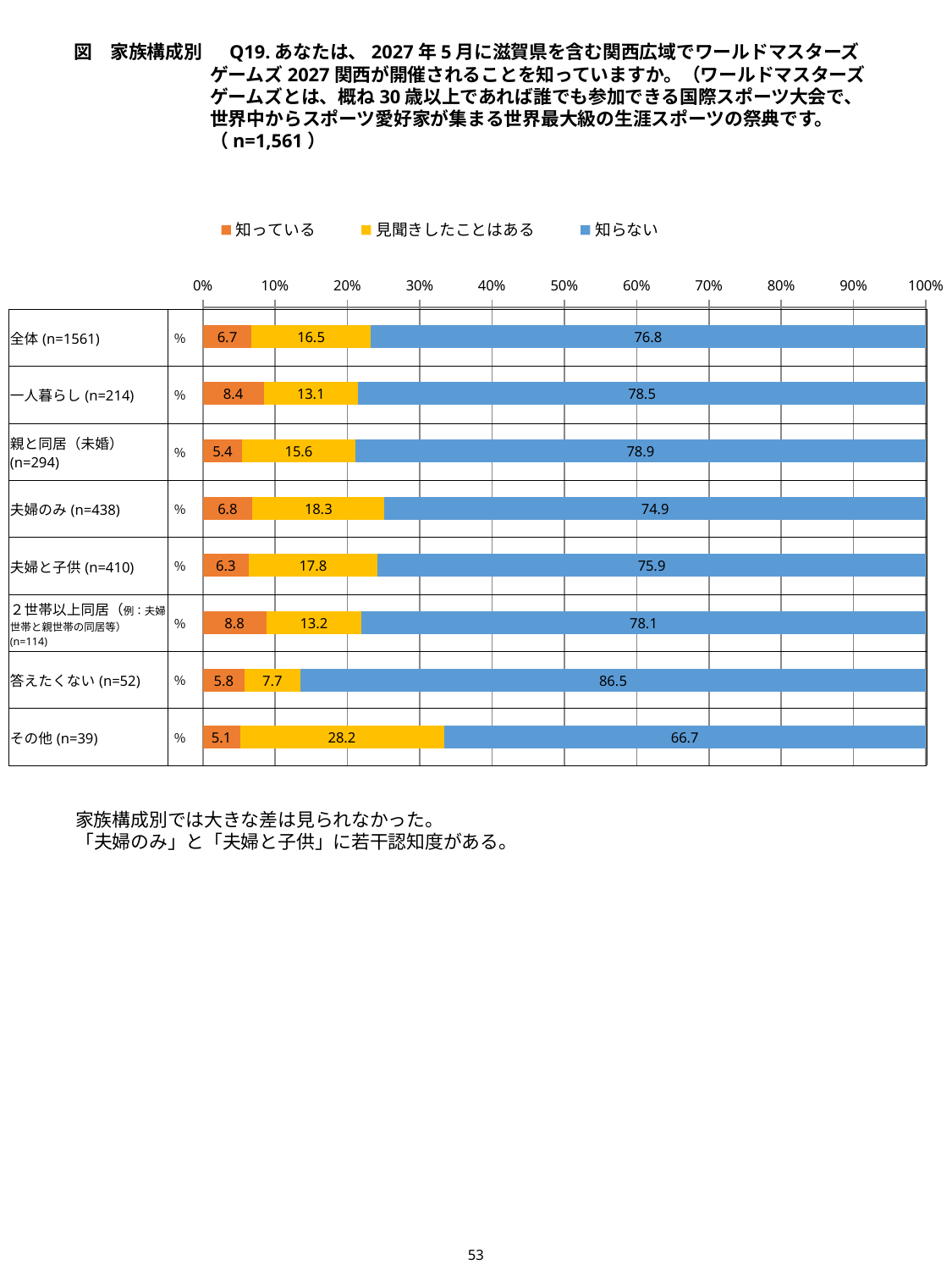
What is the value of 知らない for 全体 (n=1561)? 76.8 What is the value of 見聞きしたことはある for その他 (n=39)? 28.2 What is the value of 知っている for 一人暮らし (n=214)? 8.4 Which category has the lowest value for 知っている? その他 (n=39) How many categories (rows) are plotted in the chart? 8 What kind of chart is shown on the slide? stacked bar chart What is the difference between the 知らない values for 答えたくない (n=52) and その他 (n=39)? 19.8 Which is larger, the 見聞きしたことはある value for 夫婦のみ (n=438) or for 夫婦と子供 (n=410)? 夫婦のみ (n=438) How many series does the legend list? 3 Which category has the highest value for 知らない? 答えたくない (n=52) What is the total of the stacked bar for 親と同居（未婚）(n=294)? 99.9 Which legend entry is shown in orange? 知っている